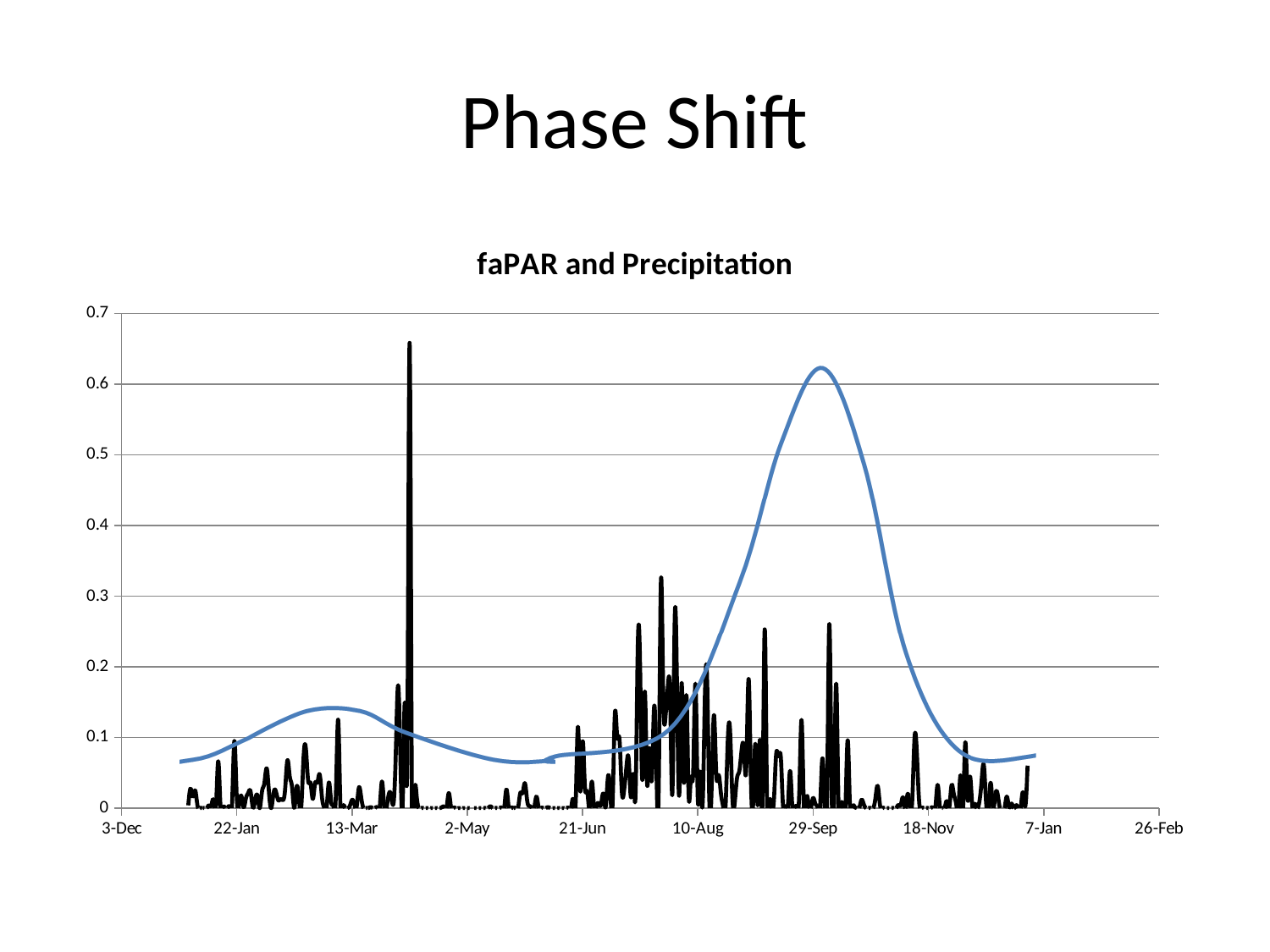
How many date labels are shown along the x axis of the chart? 10 Is the peak of the smooth blue line greater or less than 0.6? greater Does the blue line rise or fall between 21-Jun and 29-Sep? rise Is the value of the blue line at 2-May greater or less than 0.1? less What kind of chart is shown on the slide? line chart Is the tallest spike of the black line greater or less than 0.6? greater What is the highest value labelled on the y axis? 0.7 What is the title of the chart? faPAR and Precipitation Does the blue line rise or fall between 29-Sep and 18-Nov? fall How many lines are plotted on the chart? 2 Near which x-axis date label does the blue line reach its highest point? 29-Sep